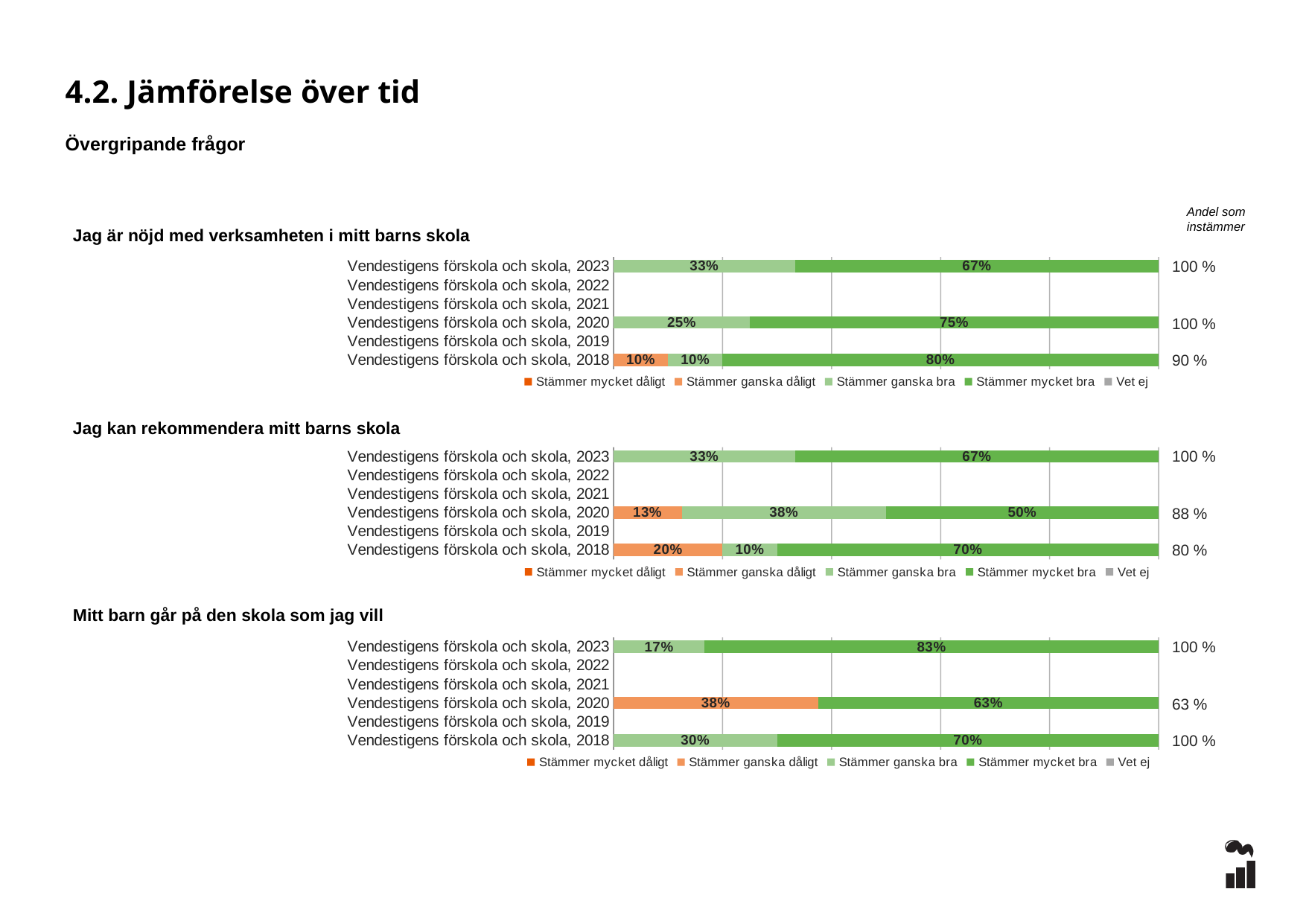
In the chart 'Jag är nöjd med verksamheten i mitt barns skola', what is the 'Stämmer mycket bra' value for Vendestigens förskola och skola, 2023? 67% In the chart 'Jag kan rekommendera mitt barns skola', what is the 'Andel som instämmer' value shown for Vendestigens förskola och skola, 2020? 88 % In the chart 'Jag kan rekommendera mitt barns skola', what is the difference between the 'Stämmer mycket bra' values for 2018 and 2020? 20% In the chart 'Mitt barn går på den skola som jag vill', what is the 'Stämmer ganska dåligt' value for Vendestigens förskola och skola, 2020? 38% In the chart 'Jag kan rekommendera mitt barns skola', which year has the highest 'Stämmer ganska dåligt' value? 2018 What kind of chart is 'Mitt barn går på den skola som jag vill'? stacked bar chart In the chart 'Jag är nöjd med verksamheten i mitt barns skola', what is the 'Stämmer ganska dåligt' value for Vendestigens förskola och skola, 2018? 10% In the chart 'Mitt barn går på den skola som jag vill', what is the 'Stämmer mycket bra' value for Vendestigens förskola och skola, 2023? 83% How many series does the legend of the chart 'Jag är nöjd med verksamheten i mitt barns skola' list? 5 In the chart 'Jag är nöjd med verksamheten i mitt barns skola', what is the 'Andel som instämmer' value shown for Vendestigens förskola och skola, 2018? 90 % In the chart 'Jag kan rekommendera mitt barns skola', what is the 'Stämmer ganska bra' value for Vendestigens förskola och skola, 2020? 38% In the chart 'Mitt barn går på den skola som jag vill', is the 'Stämmer mycket bra' value for 2023 larger or smaller than for 2018? larger